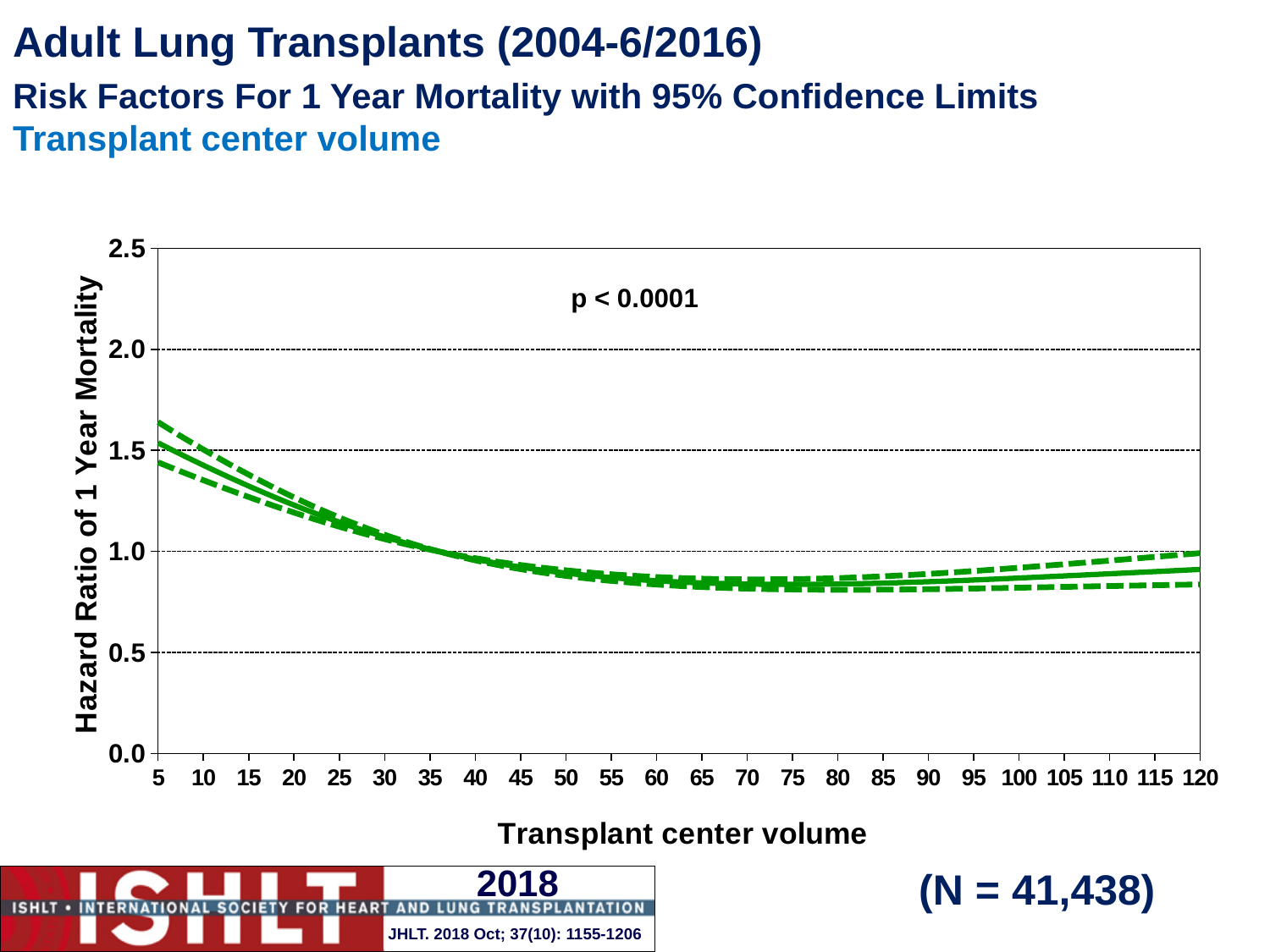
Does the hazard ratio rise or fall as transplant center volume increases from 5 to 70? fall How many lines are plotted on the chart (solid and dashed)? 3 Is the hazard ratio (solid line) at a transplant center volume of 5 greater or less than 1.0? greater What kind of chart is shown on the slide? Line chart What is the title of the y axis? Hazard Ratio of 1 Year Mortality Which has the higher hazard ratio: a transplant center volume of 5 or a volume of 70? 5 Is the hazard ratio (solid line) at a transplant center volume of 70 greater or less than 1.0? less What p-value is printed on the chart? p < 0.0001 Is the upper confidence limit at a transplant center volume of 5 greater or less than 1.5? greater What sample size (N) is shown on the slide? N = 41,438 What is the title of the x axis? Transplant center volume